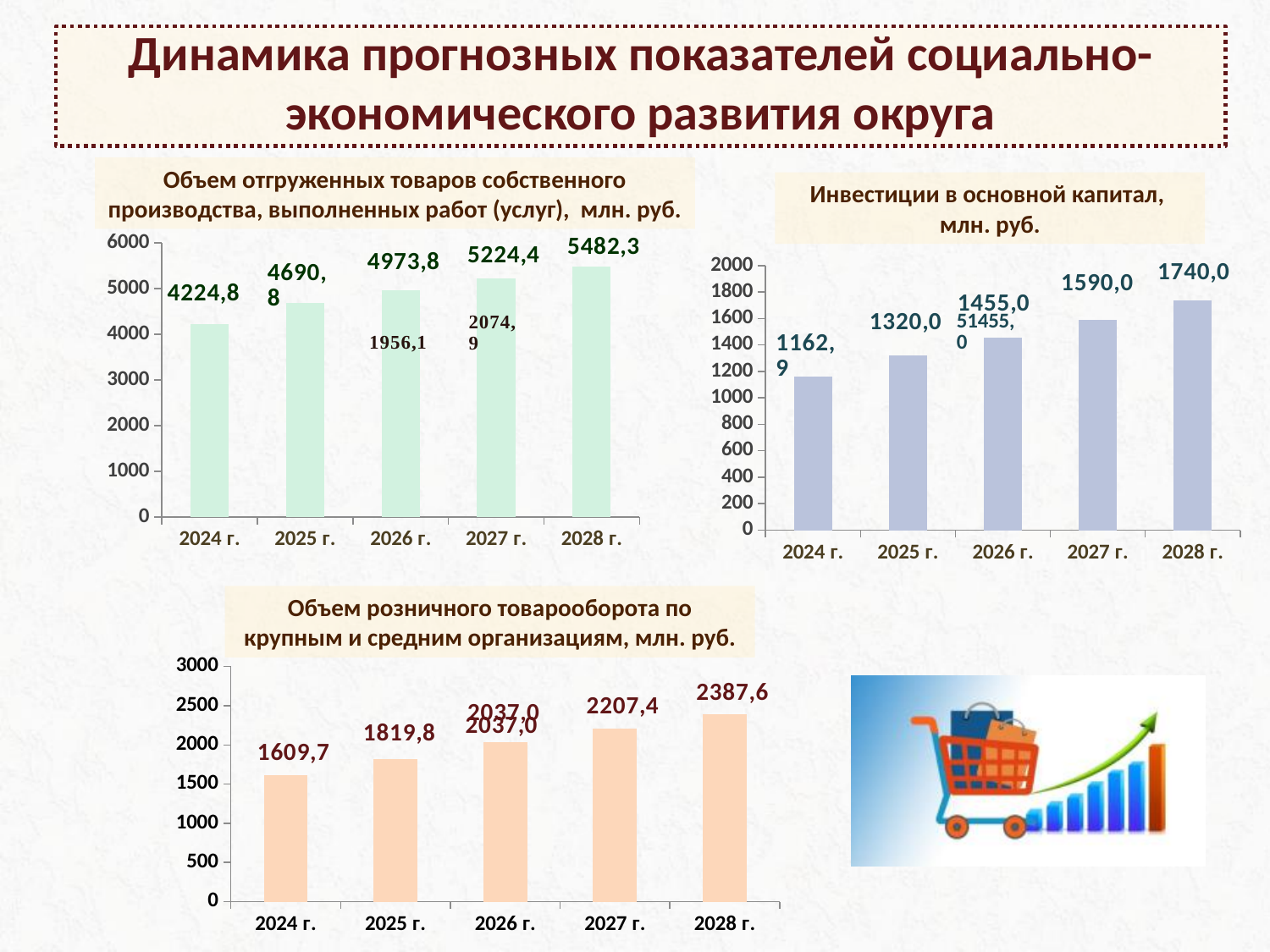
How many years are shown on the x axis of the chart 'Объем розничного товарооборота по крупным и средним организациям, млн. руб.'? 5 In the chart 'Инвестиции в основной капитал, млн. руб.', what is the difference between the values for 2028 г. and 2024 г.? 577,1 In the chart 'Инвестиции в основной капитал, млн. руб.', which year has the highest value? 2028 г. What kind of chart is 'Инвестиции в основной капитал, млн. руб.'? bar chart In the chart 'Объем розничного товарооборота по крупным и средним организациям, млн. руб.', what is the value for 2025 г.? 1819,8 In the chart 'Объем отгруженных товаров собственного производства, выполненных работ (услуг), млн. руб.', what is the value for 2024 г.? 4224,8 In the chart 'Объем розничного товарооборота по крупным и средним организациям, млн. руб.', which is larger: the value for 2026 г. or 2027 г.? 2027 г. In the chart 'Инвестиции в основной капитал, млн. руб.', is the value for 2025 г. greater or less than 1400? less In the chart 'Объем отгруженных товаров собственного производства, выполненных работ (услуг), млн. руб.', do the values rise or fall from 2024 г. to 2028 г.? rise In the chart 'Объем розничного товарооборота по крупным и средним организациям, млн. руб.', which year has the lowest value? 2024 г. In the chart 'Инвестиции в основной капитал, млн. руб.', what is the value for 2027 г.? 1590,0 In the chart 'Объем отгруженных товаров собственного производства, выполненных работ (услуг), млн. руб.', what is the difference between the values for 2028 г. and 2024 г.? 1257,5